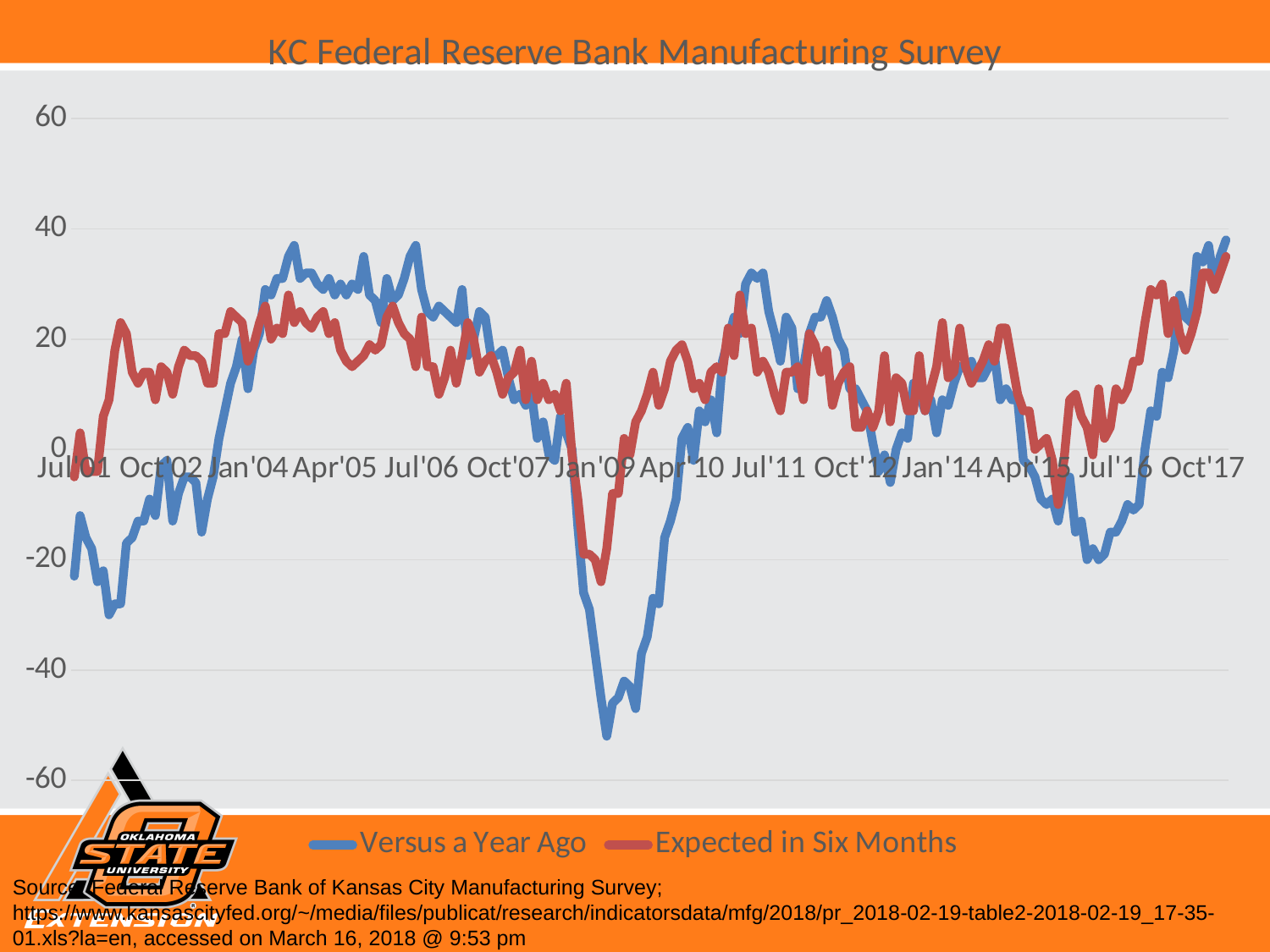
How many date labels are shown along the x axis? 14 Does the Versus a Year Ago series rise or fall between Jan'09 and Jul'11? rise Which series reaches the lowest point on the chart? Versus a Year Ago Is the value of the Versus a Year Ago series at Jul'01 greater or less than 0? less Around Jan'09, which series has the lower value, Versus a Year Ago or Expected in Six Months? Versus a Year Ago Which series is drawn in red? Expected in Six Months Is the lowest value of the Versus a Year Ago series greater or less than -40? less What is the title of the chart? KC Federal Reserve Bank Manufacturing Survey How many series does the legend list? 2 Is the value of the Versus a Year Ago series at Oct'17 greater or less than 20? greater At Jul'01, which series has the higher value, Versus a Year Ago or Expected in Six Months? Expected in Six Months What kind of chart is shown on the slide? line chart